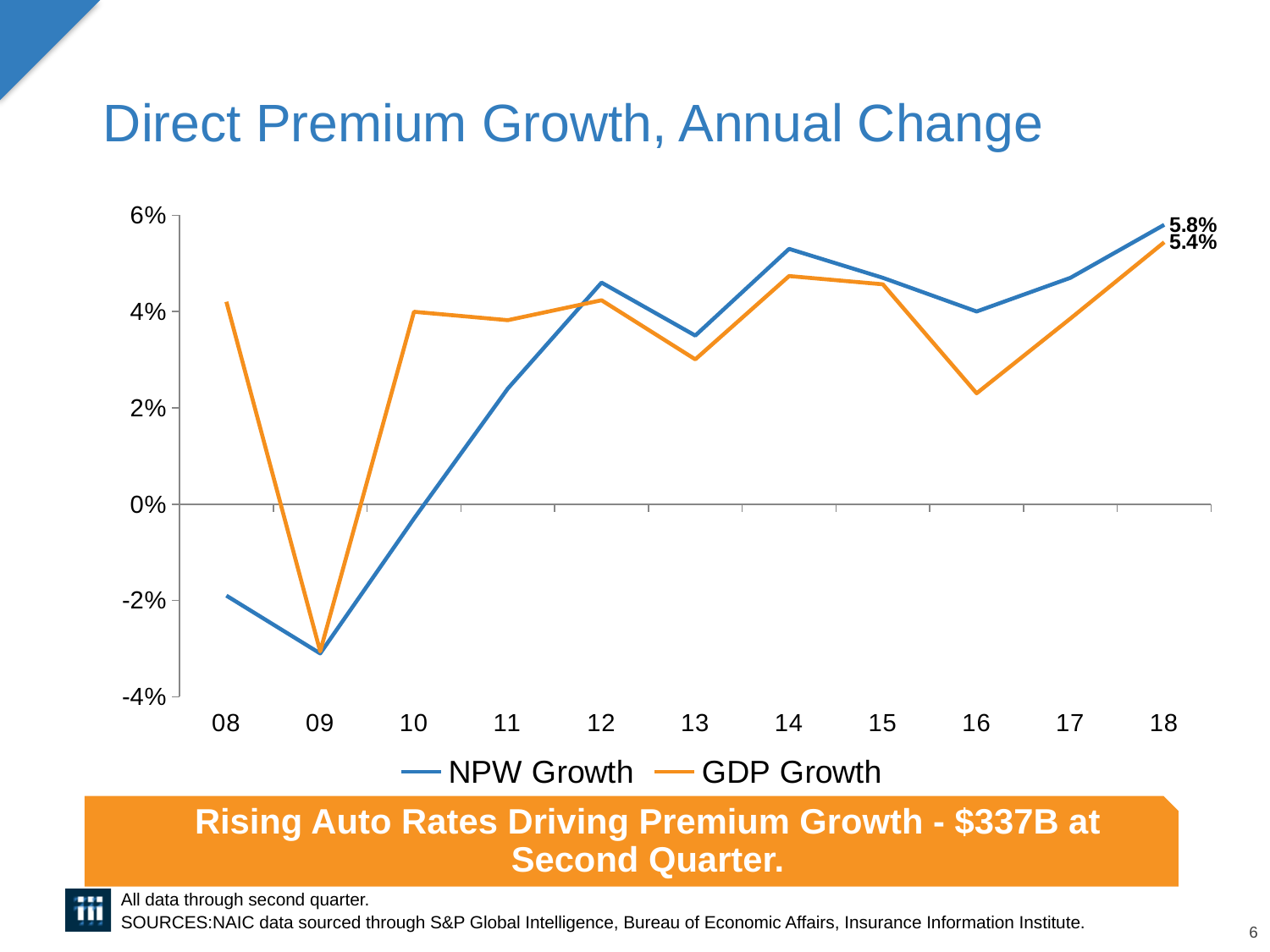
In which year is NPW Growth at its lowest? 09 Is the NPW Growth value for 09 greater or less than -2%? less How many series does the legend list? 2 How many years are shown on the x axis? 11 In 16, which series has the larger value, NPW Growth or GDP Growth? NPW Growth What is the GDP Growth value for 18? 5.4% What is the difference between NPW Growth and GDP Growth in 18? 0.4% What is the NPW Growth value for 18? 5.8% In which year is GDP Growth at its highest? 18 Is the GDP Growth value for 16 greater or less than 2%? greater What kind of chart is shown on the slide? Line chart In 10, which series has the larger value, NPW Growth or GDP Growth? GDP Growth